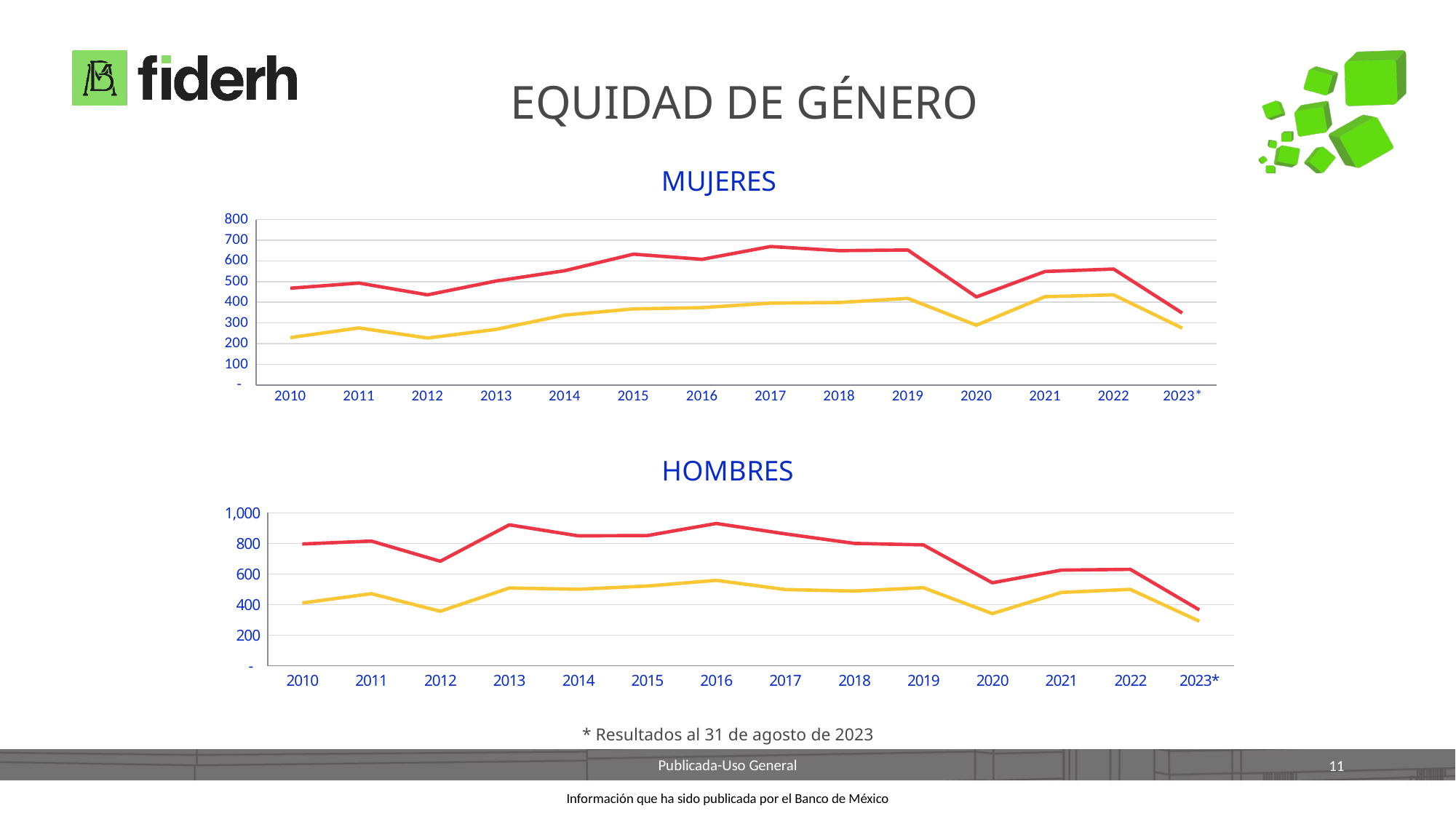
In the HOMBRES chart, in which year does the yellow line reach its highest value? 2016 In the HOMBRES chart, does the red line rise or fall from 2019 to 2020? fall In the MUJERES chart, is the value of the red line for 2010 greater or less than 400? greater In the MUJERES chart, is the value of the yellow line for 2010 greater or less than 300? less What kind of chart is the MUJERES chart? line chart In the MUJERES chart, in which year does the red line reach its lowest value? 2023* In the HOMBRES chart, in which year does the yellow line reach its lowest value? 2023* In the MUJERES chart, which year has the larger value on the red line, 2017 or 2020? 2017 In the HOMBRES chart, is the value of the yellow line for 2012 greater or less than 400? less In the MUJERES chart, in which year does the red line reach its highest value? 2017 How many years are shown on the x axis of the HOMBRES chart? 14